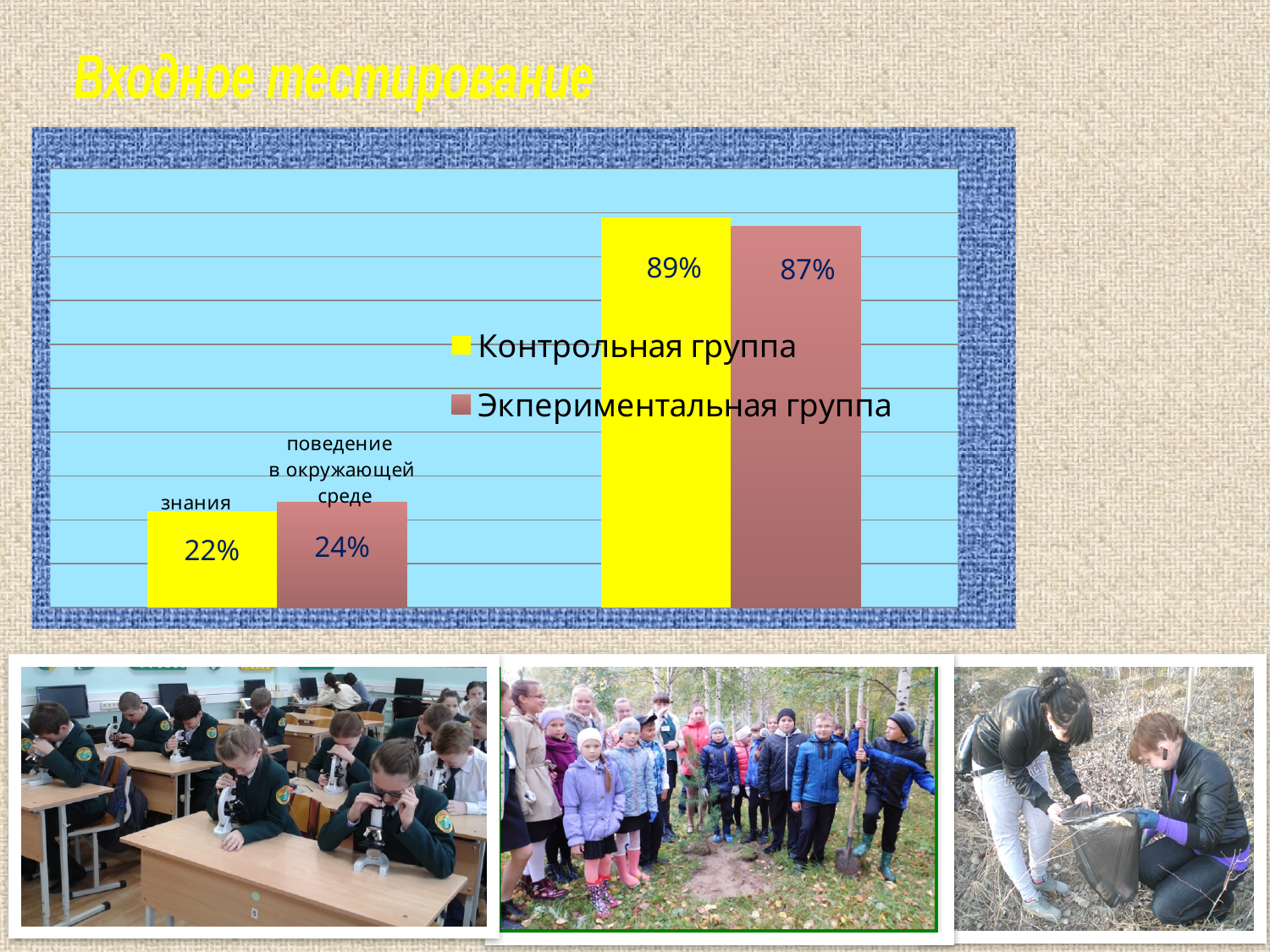
What is the value of the Экпериментальная группа bar in the left pair of bars? 24% In the right pair of bars, which series has the larger value? Контрольная группа What is the value of the Экпериментальная группа bar in the right pair of bars? 87% What colour are the bars for Контрольная группа? yellow How many series does the chart legend list? 2 What is the value of the Контрольная группа bar in the right pair of bars? 89% What type of chart is shown on the slide? bar chart What is the highest value shown on the chart? 89% In the left pair of bars, which series has the larger value? Экпериментальная группа In the right pair of bars, what is the difference between the Контрольная группа value and the Экпериментальная группа value? 2% What is the value of the Контрольная группа bar in the left pair of bars? 22% What are the two series named in the chart legend? Контрольная группа and Экпериментальная группа